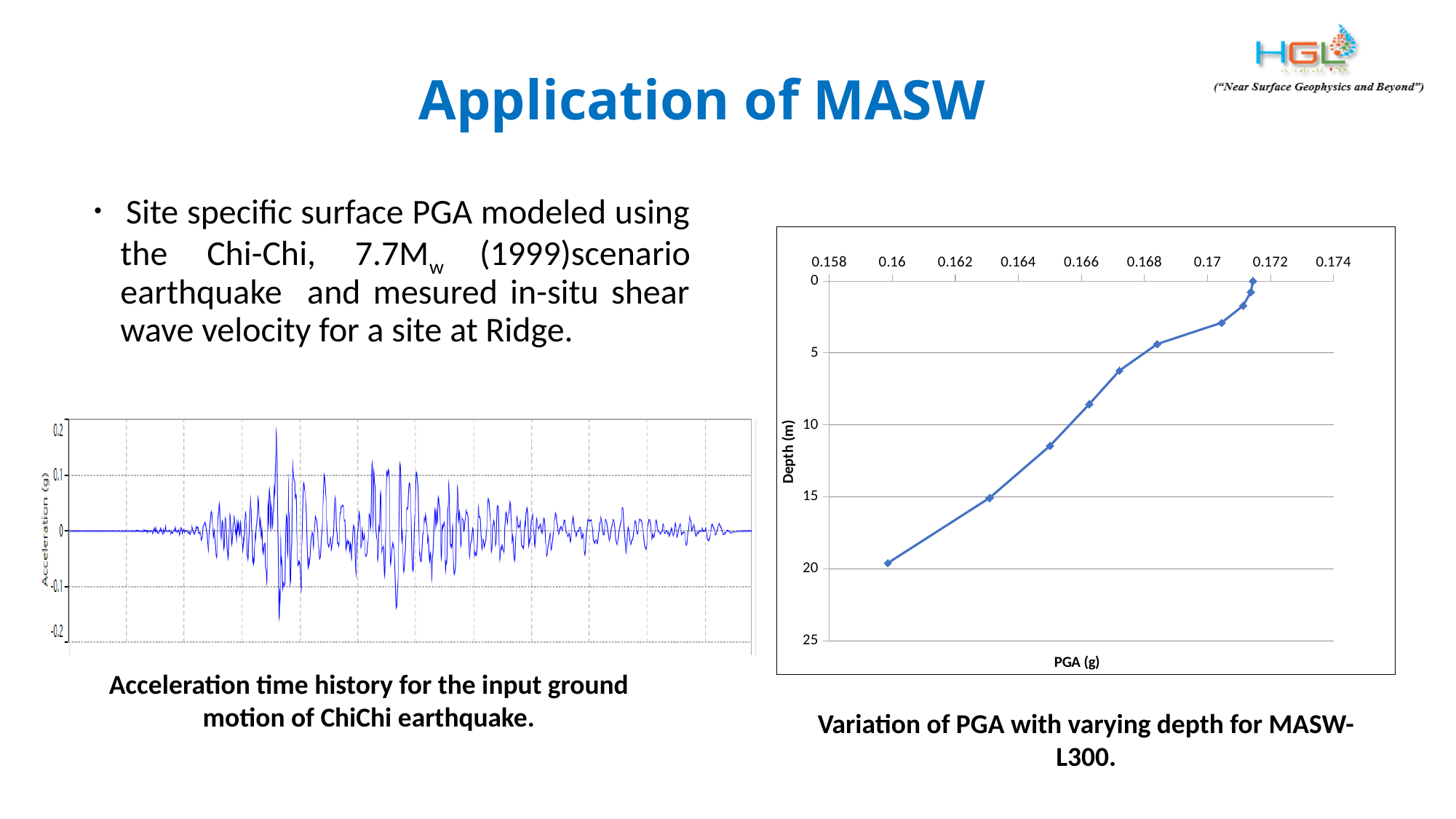
In the right-hand chart (Variation of PGA with varying depth), does PGA increase or decrease as depth increases? decrease What kind of chart is the right-hand chart titled 'Variation of PGA with varying depth for MASW-L300'? line chart In the right-hand chart (Variation of PGA with varying depth), is the PGA value at the deepest plotted point (around 20 m) greater or less than 0.162? less In the right-hand chart (Variation of PGA with varying depth), what is the label of the vertical axis? Depth (m) In the right-hand chart (Variation of PGA with varying depth), at which depth is the PGA highest? 0 m (the surface) In the right-hand chart (Variation of PGA with varying depth), which has the larger PGA: the point at depth 5 m or the point at depth 15 m? the point at depth 5 m What kind of chart is the left-hand chart showing the acceleration time history of the ChiChi earthquake? line chart In the right-hand chart (Variation of PGA with varying depth), is the PGA value at the surface (depth 0) greater or less than 0.17? greater In the left-hand chart (Acceleration time history), is the peak positive acceleration greater or less than 0.1? greater In the left-hand chart (Acceleration time history), what is the label of the vertical axis? Acceleration (g) In the right-hand chart (Variation of PGA with varying depth), how many data points are plotted? 10 In the right-hand chart (Variation of PGA with varying depth), what is the label of the horizontal axis? PGA (g)